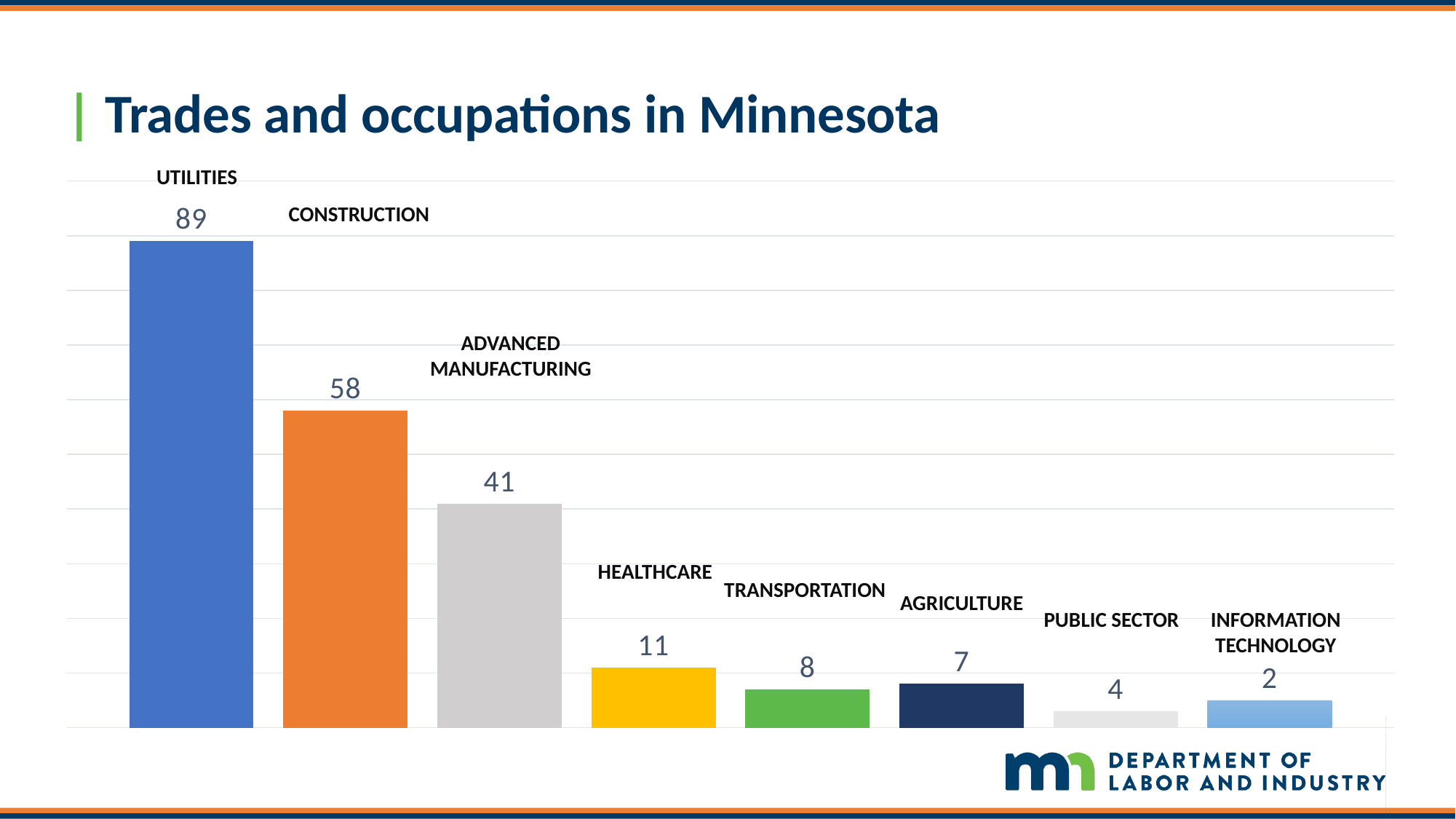
Which category has the lowest value? Information Technology Which is larger, the value for Construction or the value for Advanced Manufacturing? Construction What kind of chart is shown on the slide? Bar chart What is the difference between the values for Healthcare and Public Sector? 7 Do the values rise or fall from left to right across the categories? Fall What is the value for Transportation? 8 How many categories are shown in the chart? 8 Which category has the highest value? Utilities What is the difference between the values for Utilities and Construction? 31 Which is larger, the value for Agriculture or the value for Transportation? Transportation What is the value for Advanced Manufacturing? 41 What is the value for Utilities? 89